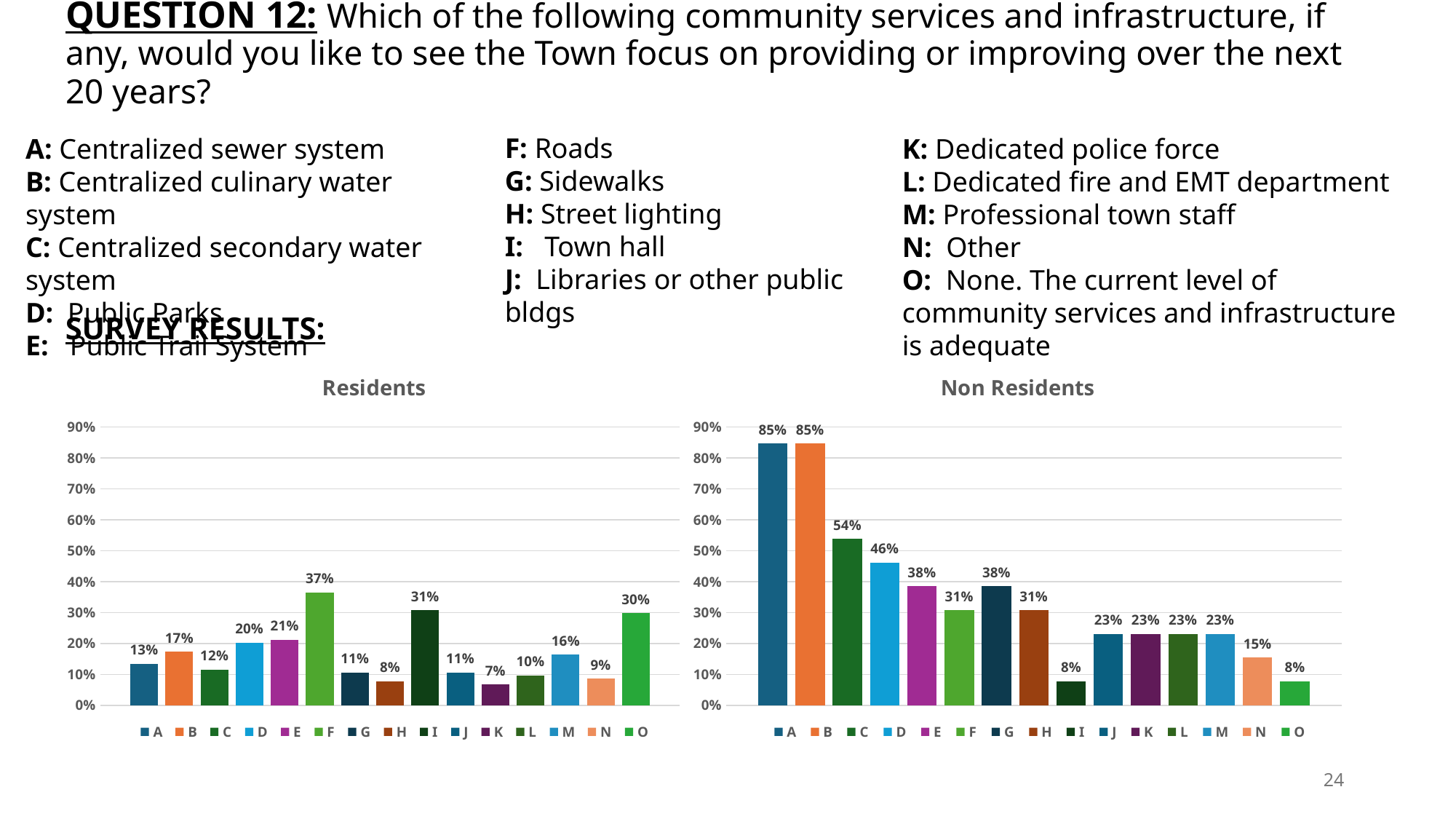
In the Residents chart, what is the value for F? 37% In the Residents chart, what is the difference between the values for I and O? 1% What is the title of the chart on the left side of the slide? Residents How many categories are plotted in the Non Residents chart? 15 In the Non Residents chart, which is larger, the value for D or the value for E? D How many entries does the legend of the Residents chart list? 15 In the Residents chart, which category has the lowest value? K In the Residents chart, is the value for O greater or less than 20%? greater In the Non Residents chart, what is the difference between the values for A and C? 31% In the Residents chart, which category has the highest value? F In the Non Residents chart, what is the value for C? 54% What kind of chart is the Non Residents chart? Bar chart